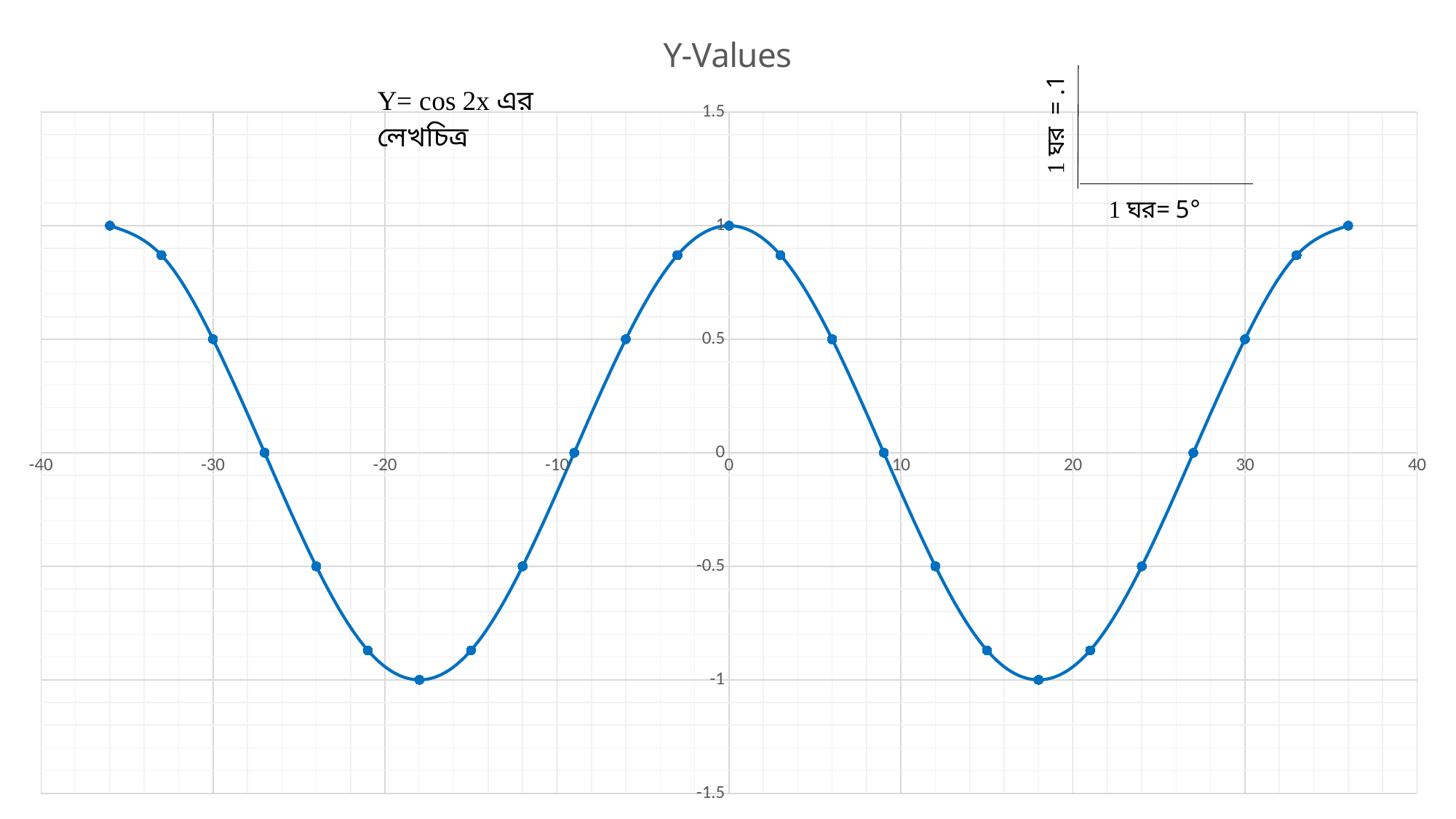
Do the y values rise or fall as x goes from 0 to 18? fall What is the y value of the plotted point at x = 30? 0.5 Is the y value of the point at x = 21 greater or less than -0.5? less What kind of chart is shown on the slide? line chart Which point has the larger y value, the one at x = 0 or the one at x = 18? x = 0 What is the title of the chart? Y-Values Is the y value of the point at x = -33 greater or less than 0.5? greater What is the highest y value reached by the plotted points? 1 What is the y value of the plotted point at x = 18? -1 What is the y value of the plotted point at x = 0? 1 What is the lowest y value reached by the plotted points? -1 What is the y value of the plotted point at x = -27? 0